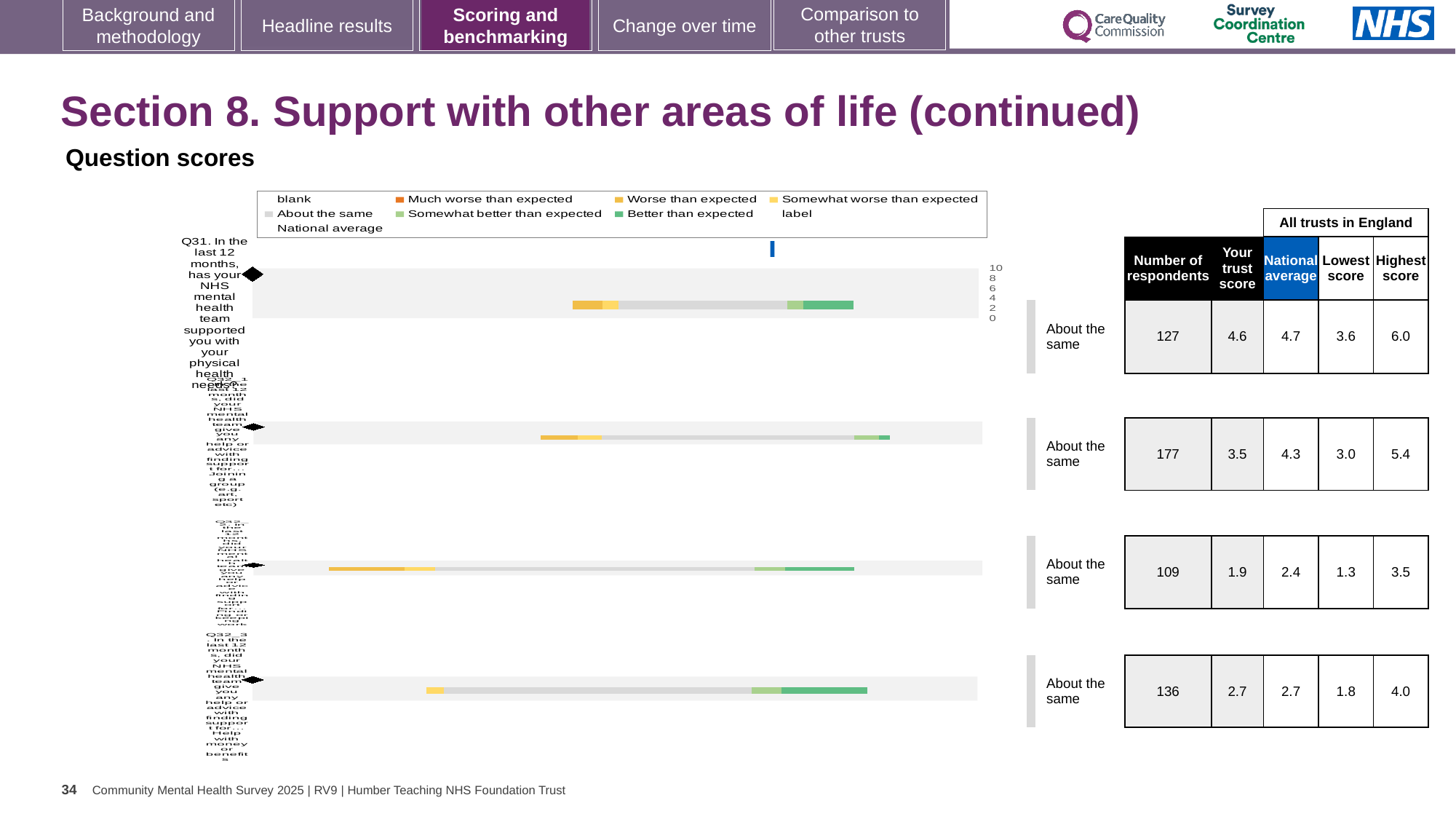
How many horizontal bars (questions) are plotted in the chart? 4 In the table beside the chart, what is the trust score for Q31 (the first row)? 4.6 In the table beside the chart, which row has the lowest number of respondents? the third row (109) In the table beside the chart, what is the highest score for the fourth row? 4.0 In the table beside the chart, which row has the highest number of respondents? the second row (177) In the table beside the chart, what is the number of respondents for Q31 (the first row)? 127 In the chart legend, which entry is shown in dark green? Better than expected In the table beside the chart, what is the national average for the second row? 4.3 For Q31 (the first row), what is the difference between the highest score and the lowest score? 2.4 What benchmark category label is shown next to each of the four bars in the chart? About the same For Q31 (the first row), which is larger: the trust score or the national average? national average What kind of chart is shown on the slide? bar chart